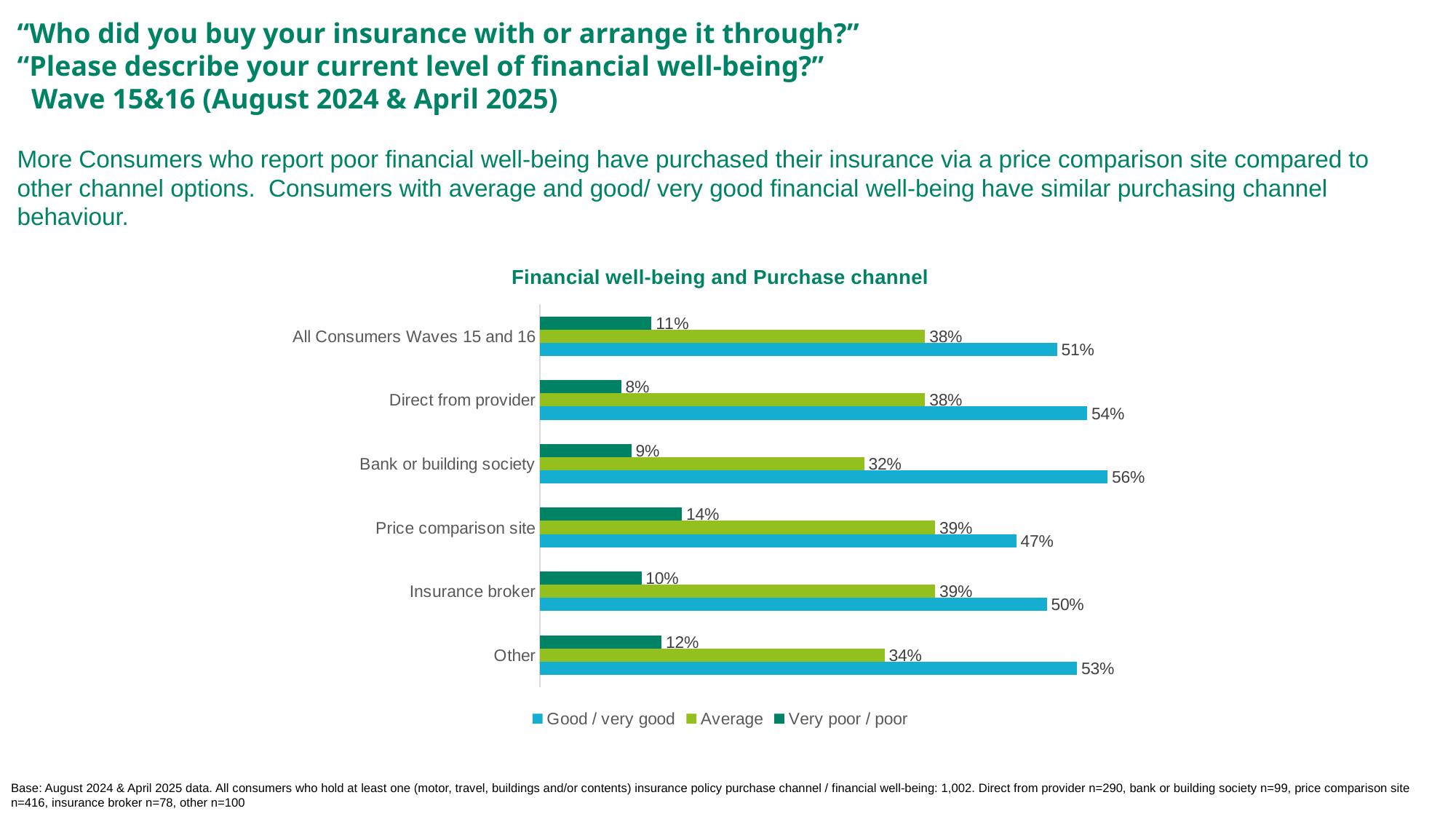
Which purchase channel has the highest Very poor / poor percentage? Price comparison site What is the Good / very good value for Bank or building society? 56% How many series does the legend list? 3 Which series is shown in light blue in the legend? Good / very good What is the difference between the Good / very good values for Direct from provider and Price comparison site? 7% How many categories are shown on the y axis of the chart? 6 Which purchase channel has the lowest Good / very good percentage? Price comparison site What percentage of consumers who bought via a price comparison site report very poor / poor financial well-being? 14% What is the Average value for Other? 34% What is the title of the chart? Financial well-being and Purchase channel Which is larger: the Average value for Bank or building society or the Average value for Insurance broker? Insurance broker What type of chart is shown on the slide? Bar chart